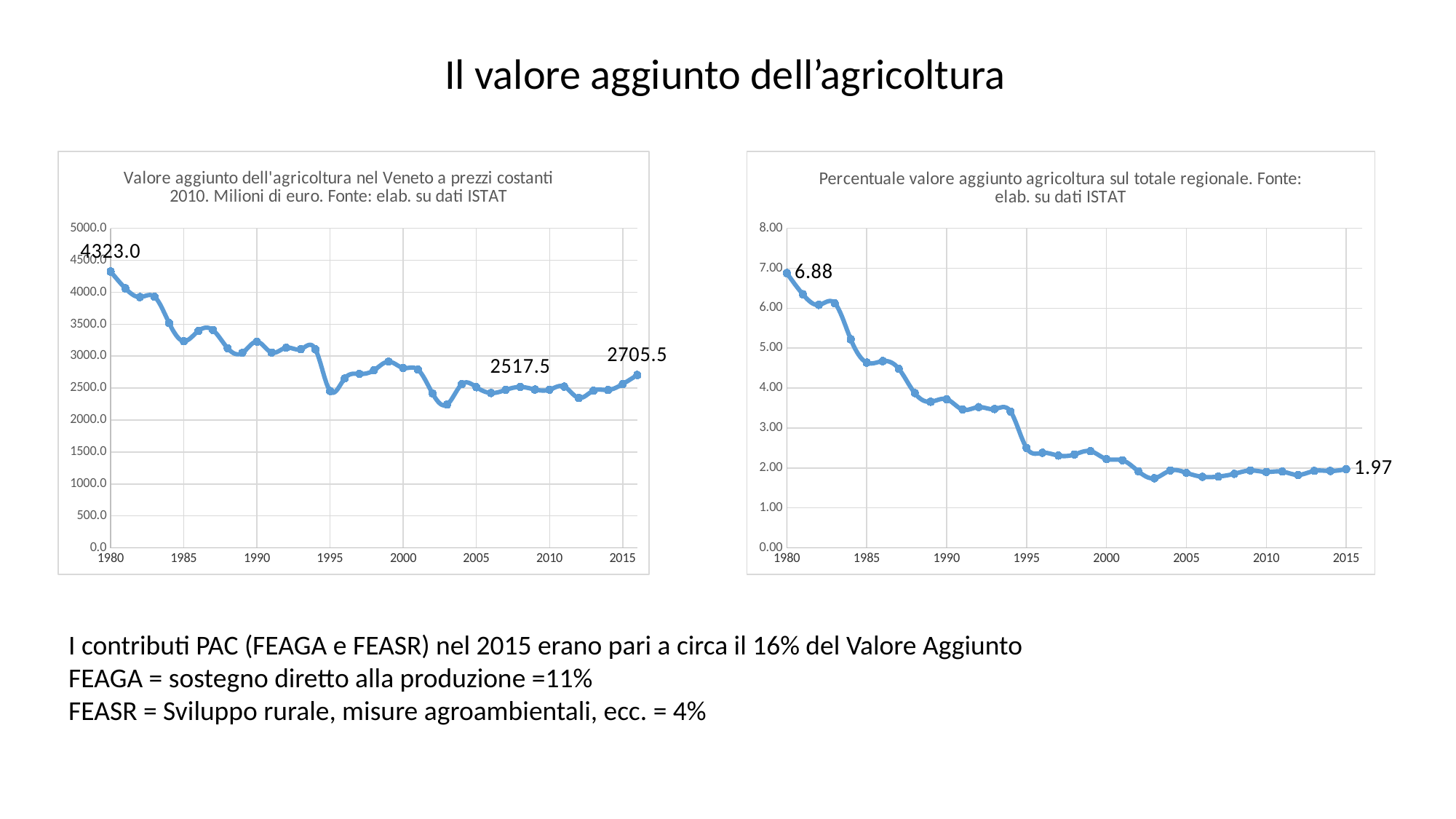
In the left chart, is the value for 2003 greater or less than 2500? less In the left chart, which year has the highest value? 1980 In the right chart, by how much did the percentage fall from 1980 (6.88) to 2015 (1.97)? 4.91 In the right chart, do the values generally rise or fall from 1980 to 2015? Fall In the left chart (Valore aggiunto dell'agricoltura nel Veneto), what is the value labelled for 1980? 4323.0 In the right chart, is the value for 1990 greater or less than 3.00? greater According to the chart titles, what is the data source for both charts? elab. su dati ISTAT In the left chart, what is the difference between the 1980 value (4323.0) and the final labelled value (2705.5)? 1617.5 In the right chart (Percentuale valore aggiunto agricoltura sul totale regionale), what is the value labelled for 1980? 6.88 What kind of chart is the left chart on the slide? Line chart In the left chart (Valore aggiunto dell'agricoltura nel Veneto), what value is labelled at the final point of the series? 2705.5 In the right chart (Percentuale valore aggiunto agricoltura sul totale regionale), what is the value labelled for 2015? 1.97